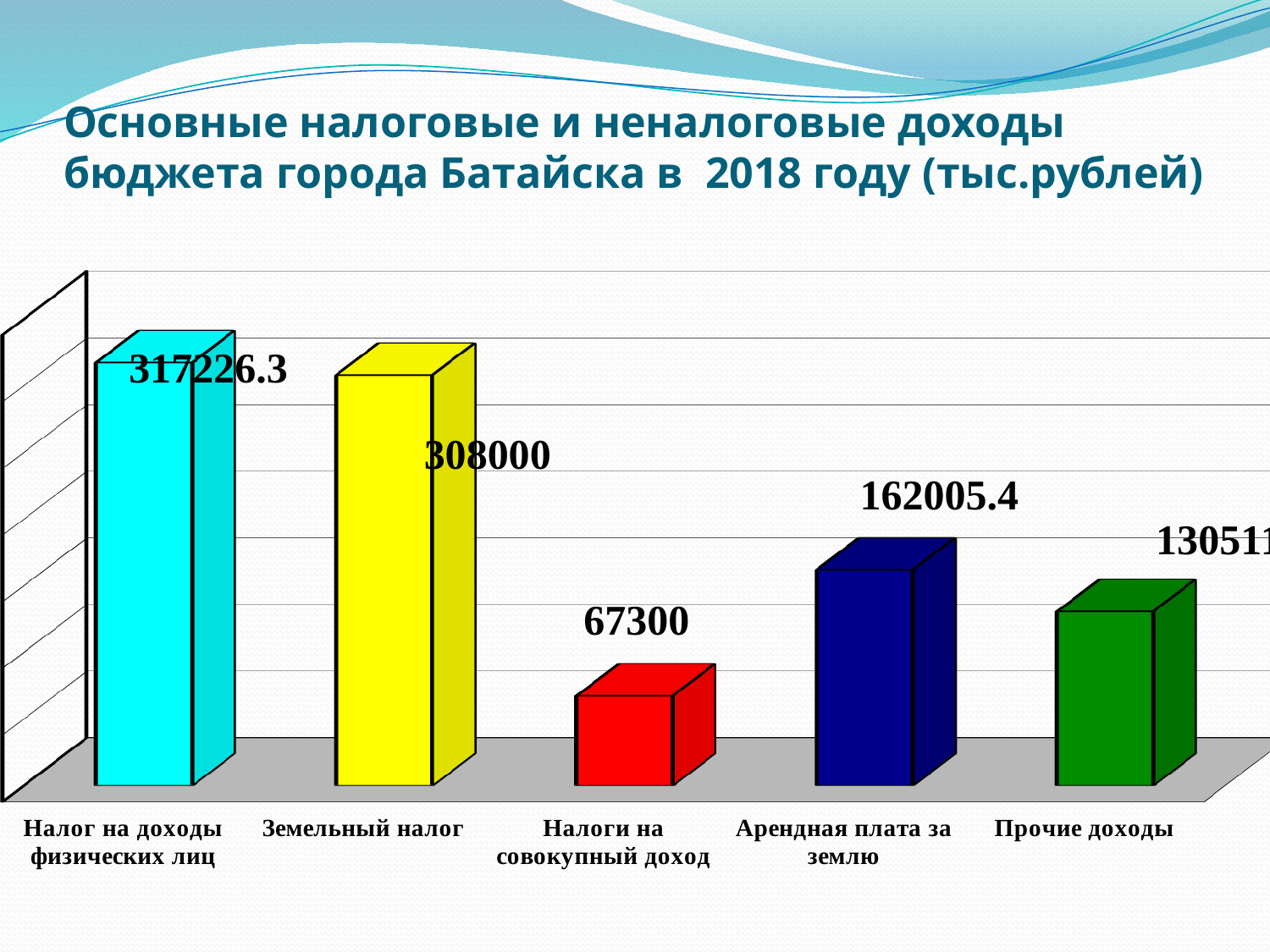
Which category has the lowest value? Налоги на совокупный доход What kind of chart is shown on the slide? Bar chart Which category has the highest value? Налог на доходы физических лиц What is the value for Налоги на совокупный доход? 67300 What is the difference between the values for Налог на доходы физических лиц and Земельный налог? 9226.3 What is the value for Арендная плата за землю? 162005.4 How many categories are shown in the chart? 5 What colour is the bar for Налоги на совокупный доход? Red What is the value for Земельный налог? 308000 What is the difference between the values for Арендная плата за землю and Налоги на совокупный доход? 94705.4 What is the value for Налог на доходы физических лиц? 317226.3 Which is larger, the value for Земельный налог or the value for Арендная плата за землю? Земельный налог